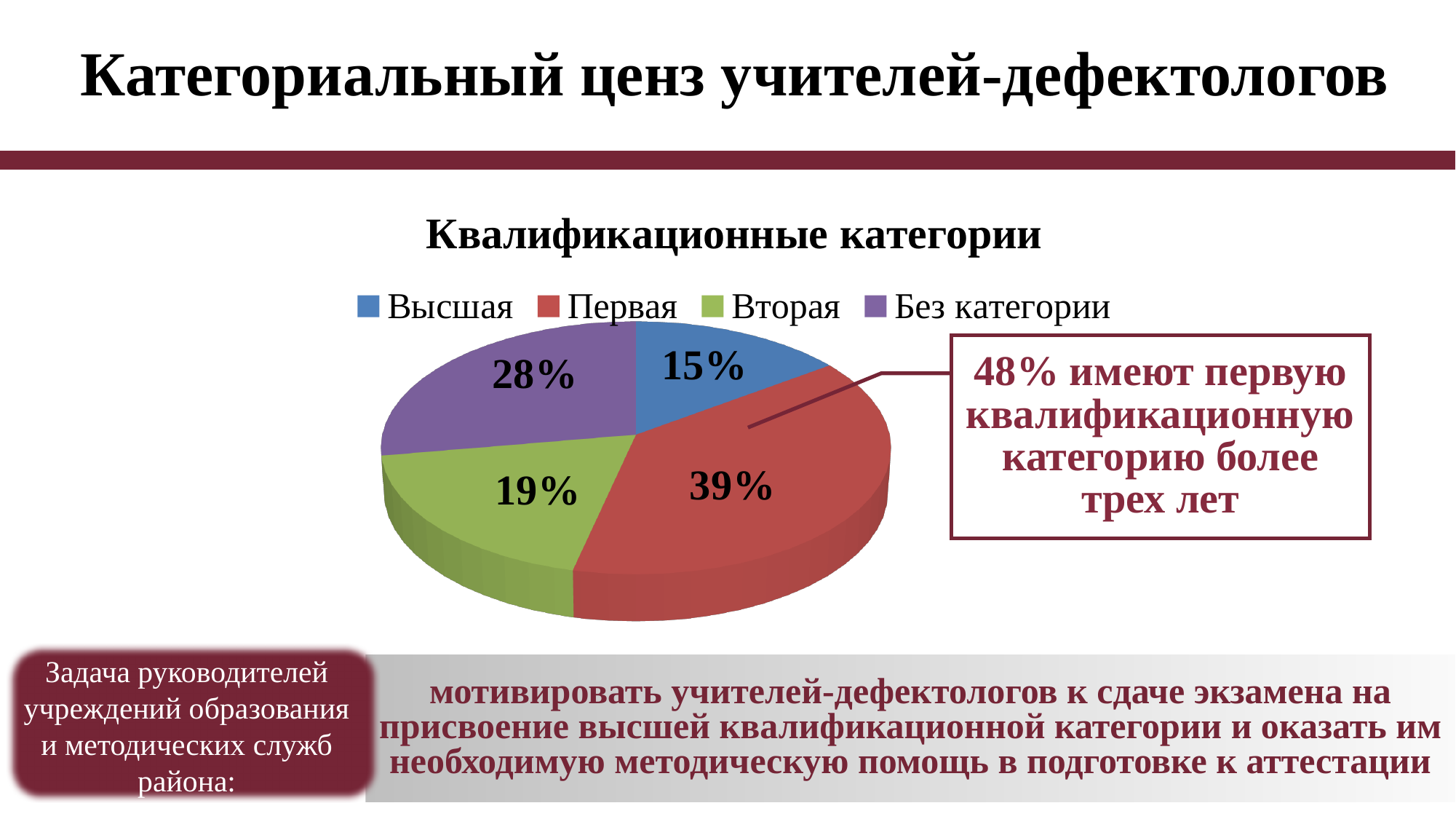
Which category has the largest slice of the pie? Первая What is the difference in percentage points between the Первая and Вторая slices? 20 What share of the pie does the Без категории category have? 28% Which category has the smallest slice of the pie? Высшая What share of the pie does the Первая category have? 39% Which slice is larger, Без категории or Вторая? Без категории What share of the pie does the Вторая category have? 19% Which colour represents the Вторая category in the legend? Green How many categories does the pie chart show? 4 What kind of chart is shown on the slide? Pie chart What share of the pie does the Высшая category have? 15% What is the chart's title? Квалификационные категории